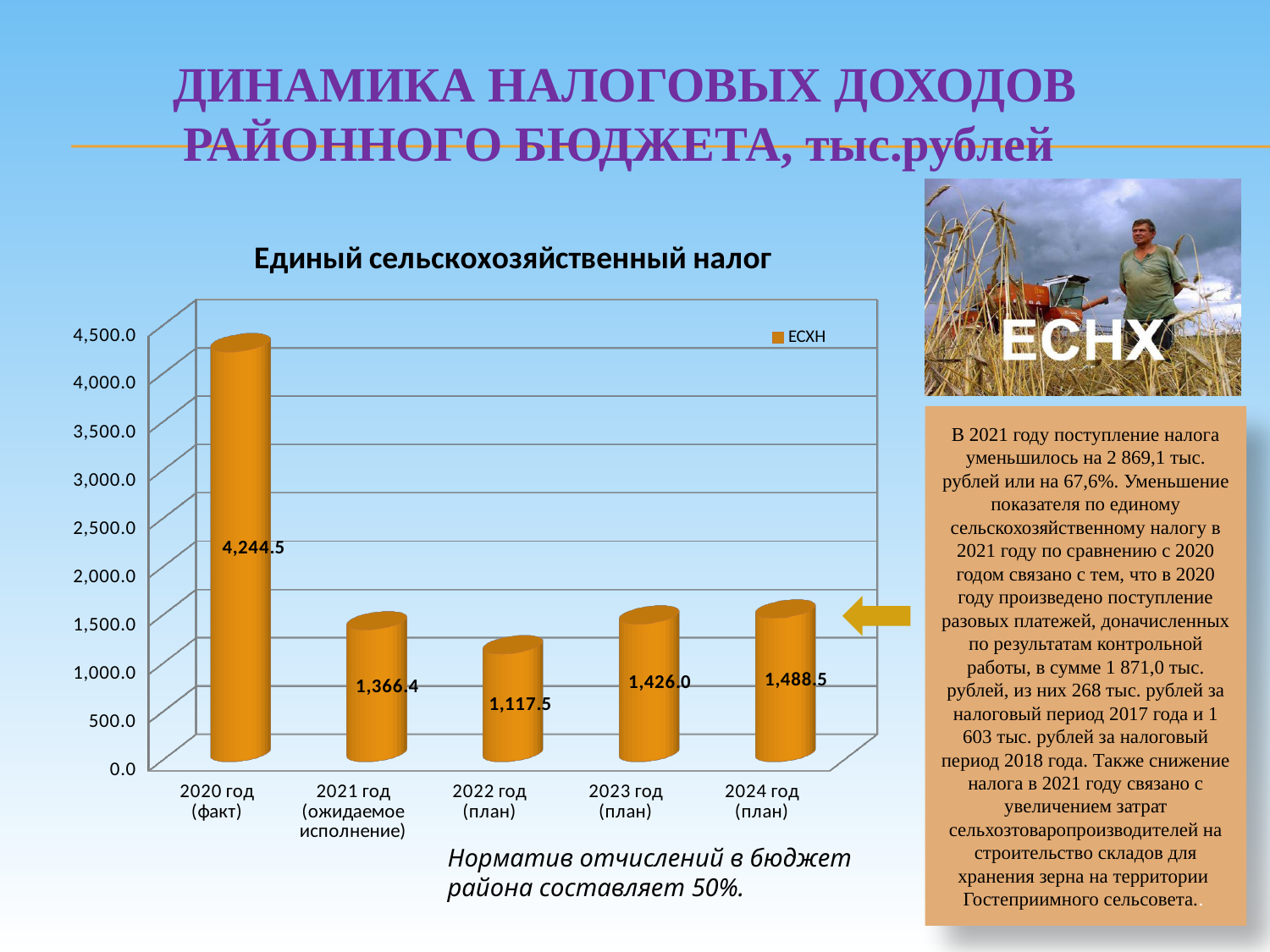
What is the difference between the values for 2020 год (факт) and 2021 год (ожидаемое исполнение)? 2,878.1 What is the value for 2024 год (план)? 1,488.5 What is the value for 2022 год (план)? 1,117.5 What is the title of the chart? Единый сельскохозяйственный налог Which year has the lowest value in the chart? 2022 год (план) What is the value for 2021 год (ожидаемое исполнение)? 1,366.4 Which year has the highest value in the chart? 2020 год (факт) What is the difference between the values for 2023 год (план) and 2022 год (план)? 308.5 What is the value for 2020 год (факт) in the chart? 4,244.5 What kind of chart is shown on the slide? Bar chart How many categories (years) are shown in the chart? 5 Which is larger: the value for 2023 год (план) or 2024 год (план)? 2024 год (план)